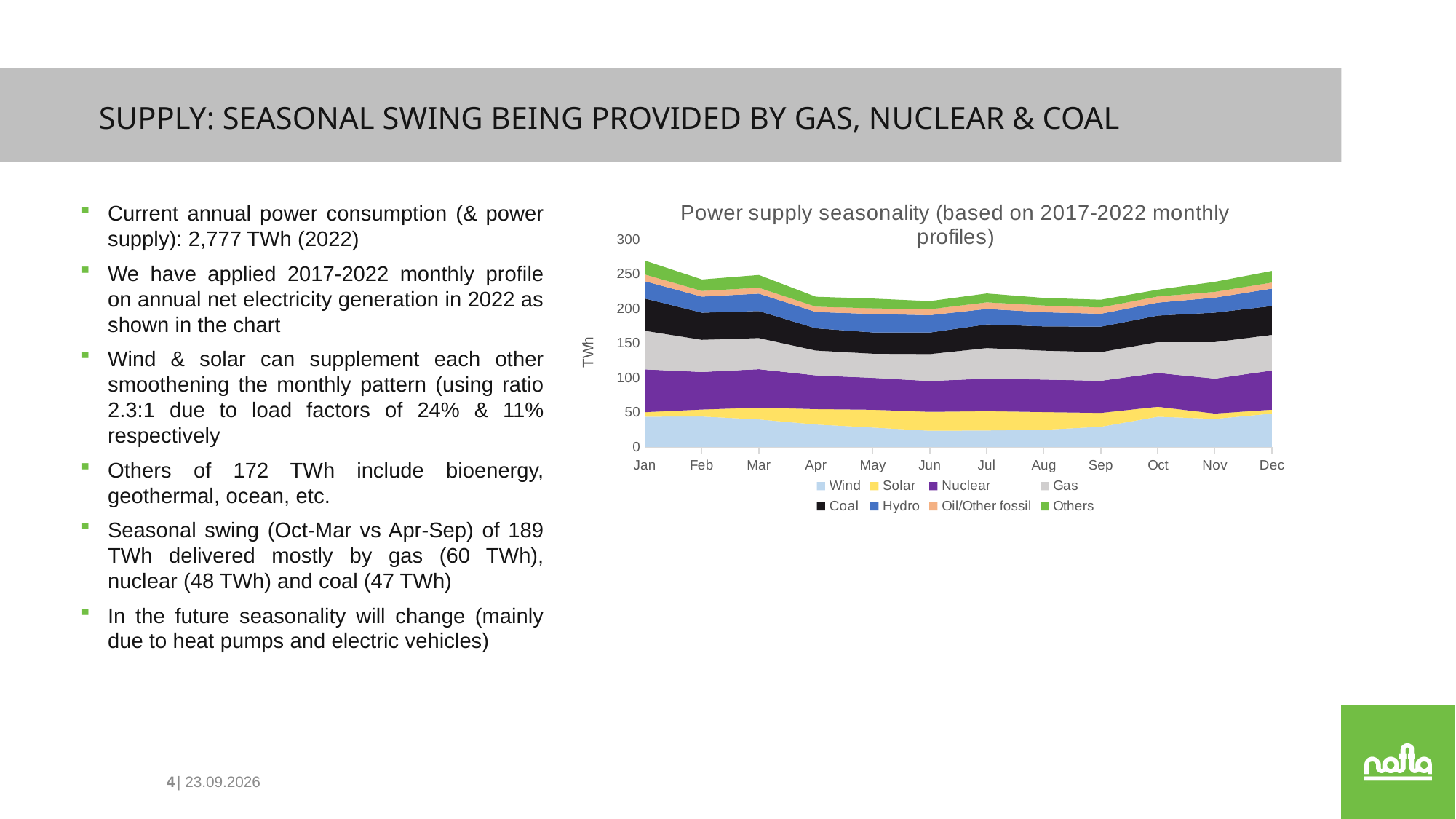
Is the total power supply in Jan greater or less than 250? greater How many months are shown along the x axis of the chart? 12 Does the total power supply rise or fall from Jan to Jun? fall Is the total power supply in Jun greater or less than 250? less Is the total power supply in Jul greater or less than 250? less In which month is the total power supply highest? Jan What kind of chart is shown on the slide? Stacked area chart How many series does the chart legend list? 8 What is the title of the chart? Power supply seasonality (based on 2017-2022 monthly profiles) What unit is shown on the y axis of the chart? TWh Which month has a larger total power supply, Jan or Jul? Jan